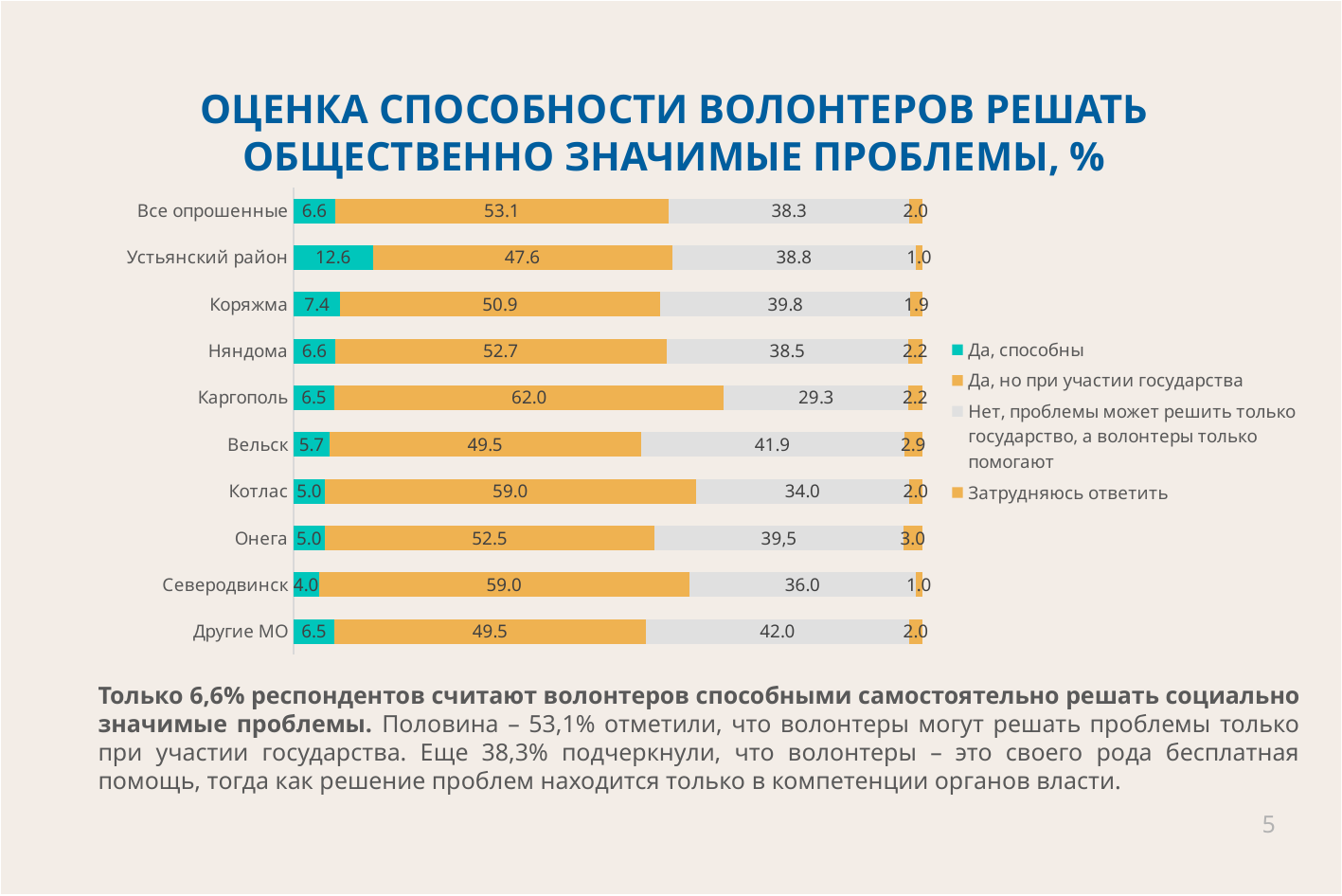
How many series does the legend list? 4 What value is shown for Устьянский район in the 'Да, способны' series? 12.6 Which category has the lowest value in the 'Нет, проблемы может решить только государство, а волонтеры только помогают' series? Каргополь What kind of chart is shown on the slide? Stacked bar chart Which category has the highest value in the 'Да, способны' series? Устьянский район What value is shown for Каргополь in the 'Да, но при участии государства' series? 62.0 Which category has the lowest value in the 'Да, способны' series? Северодвинск What value is shown for Онега in the 'Затрудняюсь ответить' series? 3.0 How many categories are shown on the chart? 10 Which is larger: the 'Да, но при участии государства' value for Котлас or for Коряжма? Котлас What is the difference between the 'Да, но при участии государства' values for Каргополь and Устьянский район? 14.4 What value is shown for Вельск in the 'Нет, проблемы может решить только государство, а волонтеры только помогают' series? 41.9